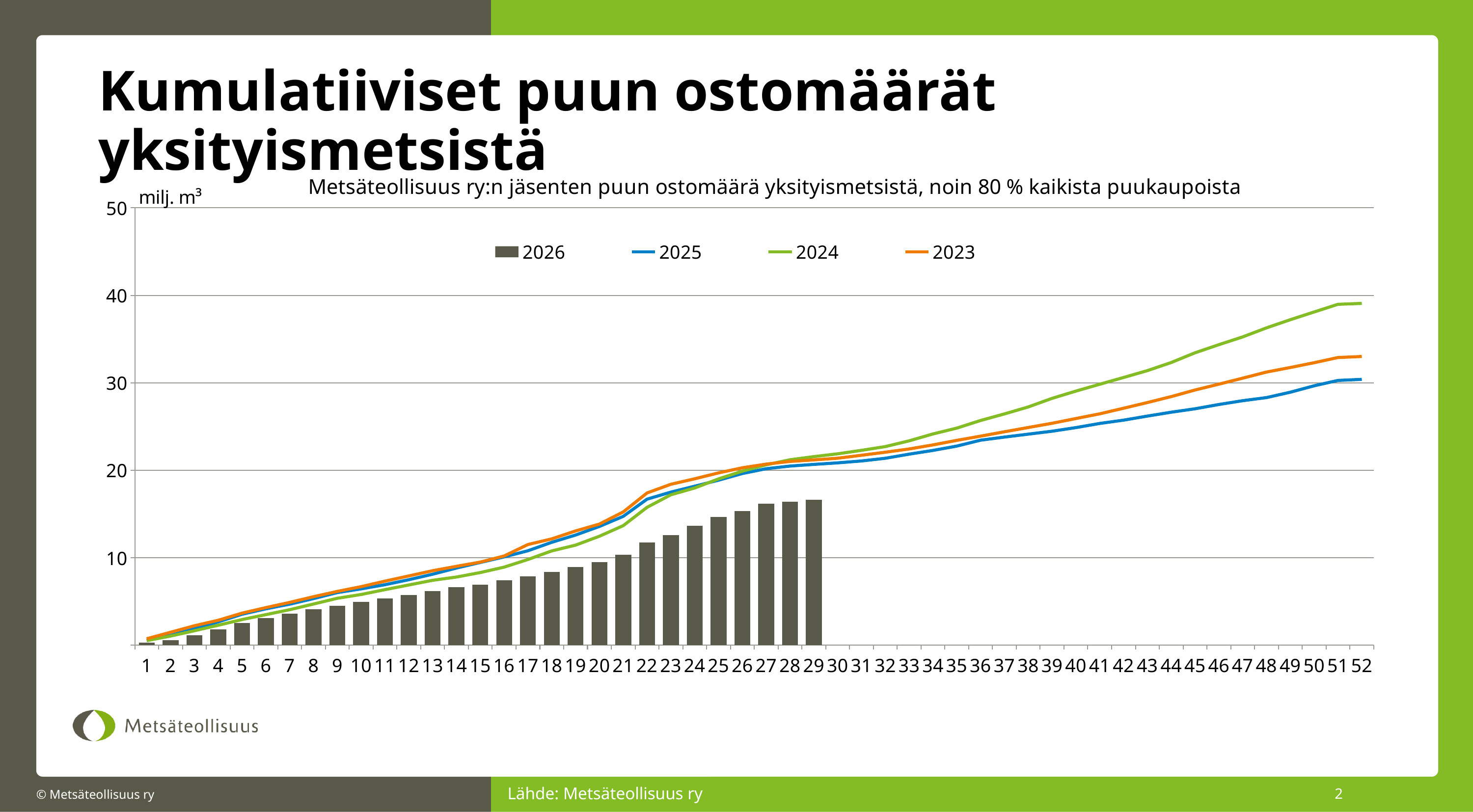
What kind of chart is this? Combined bar and line chart How many series does the chart legend list? 4 Is the value for the 2026 bar at week 29 greater or less than 20? less Which series has the lowest value at week 52? 2025 Is the value for the 2026 bar at week 10 greater or less than 10? less Which series has the highest value at week 52? 2024 At week 29, which is larger: the 2026 bar or the 2025 line? 2025 Up to which week are bars plotted for the 2026 series? 29 How many week categories are shown on the x axis? 52 Do the line series rise or fall along the x axis from week 1 to week 52? rise Which series in the legend is shown as bars rather than a line? 2026 Is the value for 2024 at week 52 greater or less than 30? greater